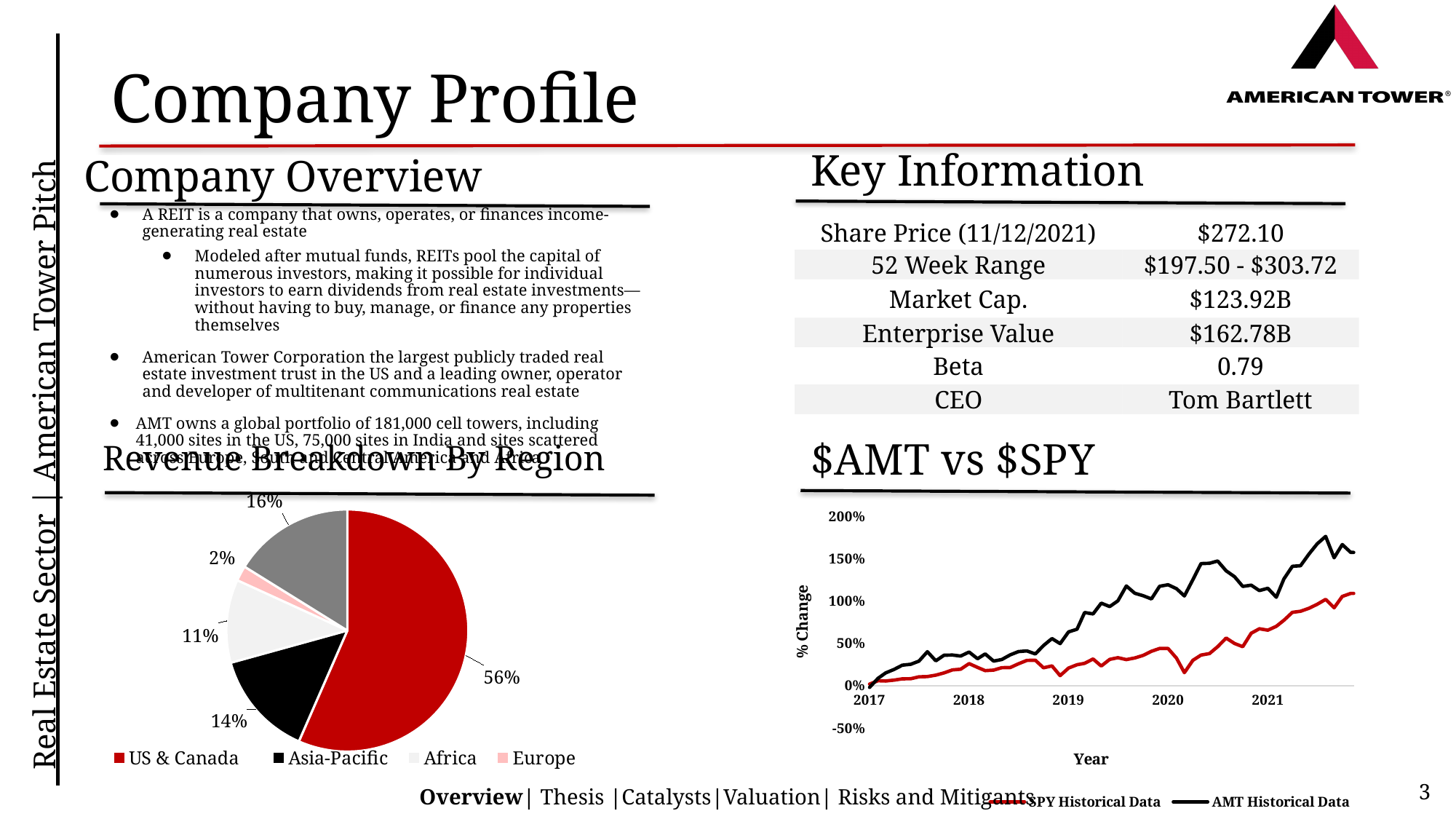
In the Revenue Breakdown By Region pie chart, what share does Asia-Pacific have? 14% What kind of chart is the Revenue Breakdown By Region chart? pie chart What kind of chart is the $AMT vs $SPY chart? line chart In the Revenue Breakdown By Region pie chart, what share does US & Canada have? 56% In the Revenue Breakdown By Region pie chart, what share does Africa have? 11% In the $AMT vs $SPY chart, which series is higher at the end of 2021, AMT Historical Data or SPY Historical Data? AMT Historical Data In the Revenue Breakdown By Region pie chart, what share does Europe have? 2% How many entries does the legend of the Revenue Breakdown By Region pie chart list? 4 In the Revenue Breakdown By Region pie chart, which region has the largest share? US & Canada How many series does the legend of the $AMT vs $SPY chart list? 2 In the Revenue Breakdown By Region pie chart, how many percentage points larger is US & Canada than Asia-Pacific? 42 percentage points In the Revenue Breakdown By Region pie chart, which labelled region has the smallest share? Europe